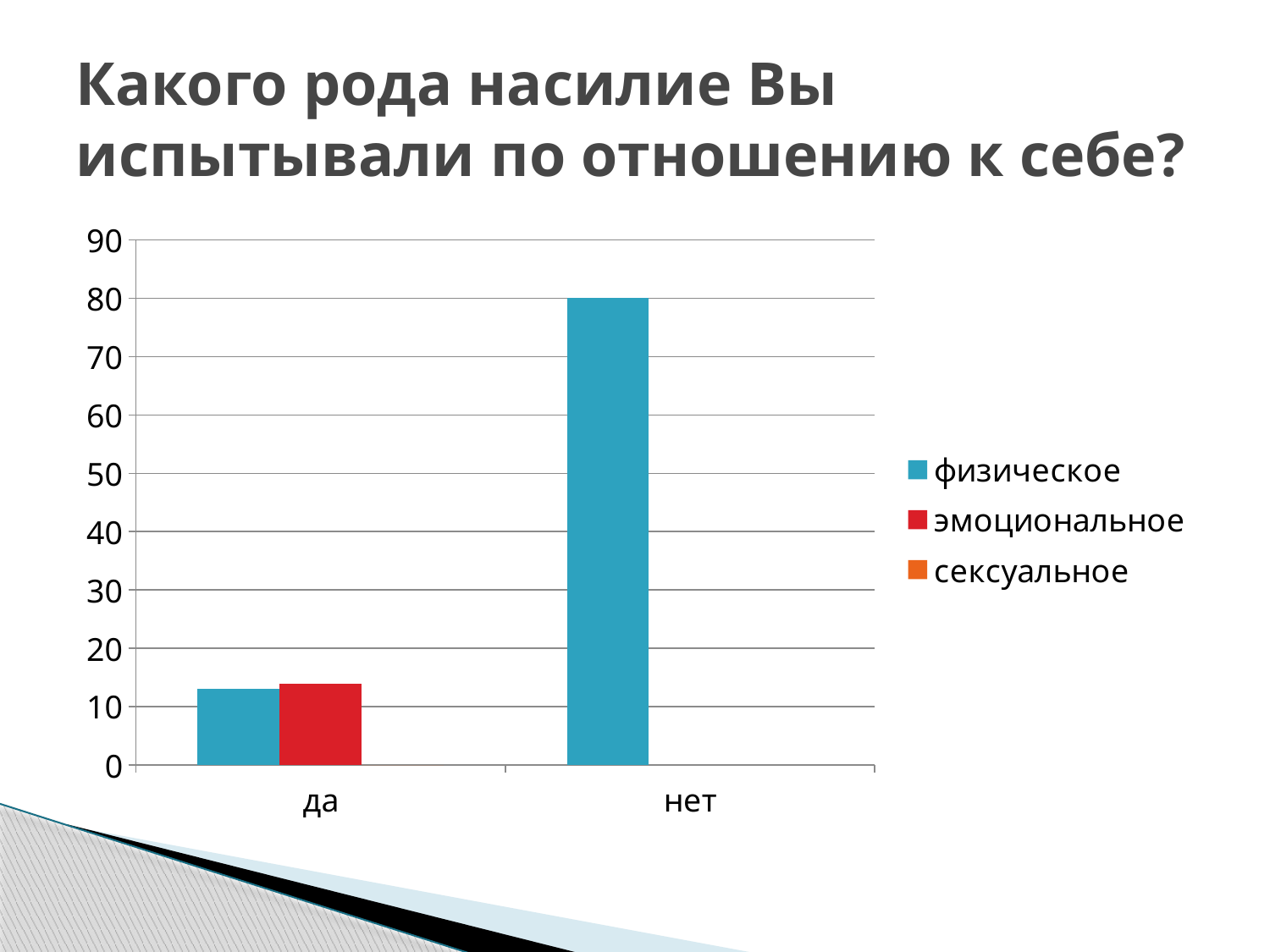
Which is larger: физическое for да or физическое for нет? физическое for нет Is the value for физическое in the да category greater or less than 20? less How many categories are shown on the x axis? 2 Which category has the lowest bar for физическое? да What kind of chart is shown on the slide? bar chart Is the value for физическое in the нет category greater or less than 70? greater How many series does the legend list? 3 What is the value for физическое in the нет category? 80 What is the title of the slide? Какого рода насилие Вы испытывали по отношению к себе? Is the value for эмоциональное in the да category greater or less than 10? greater Which series is shown in red in the legend? эмоциональное Which category has the highest bar for физическое? нет